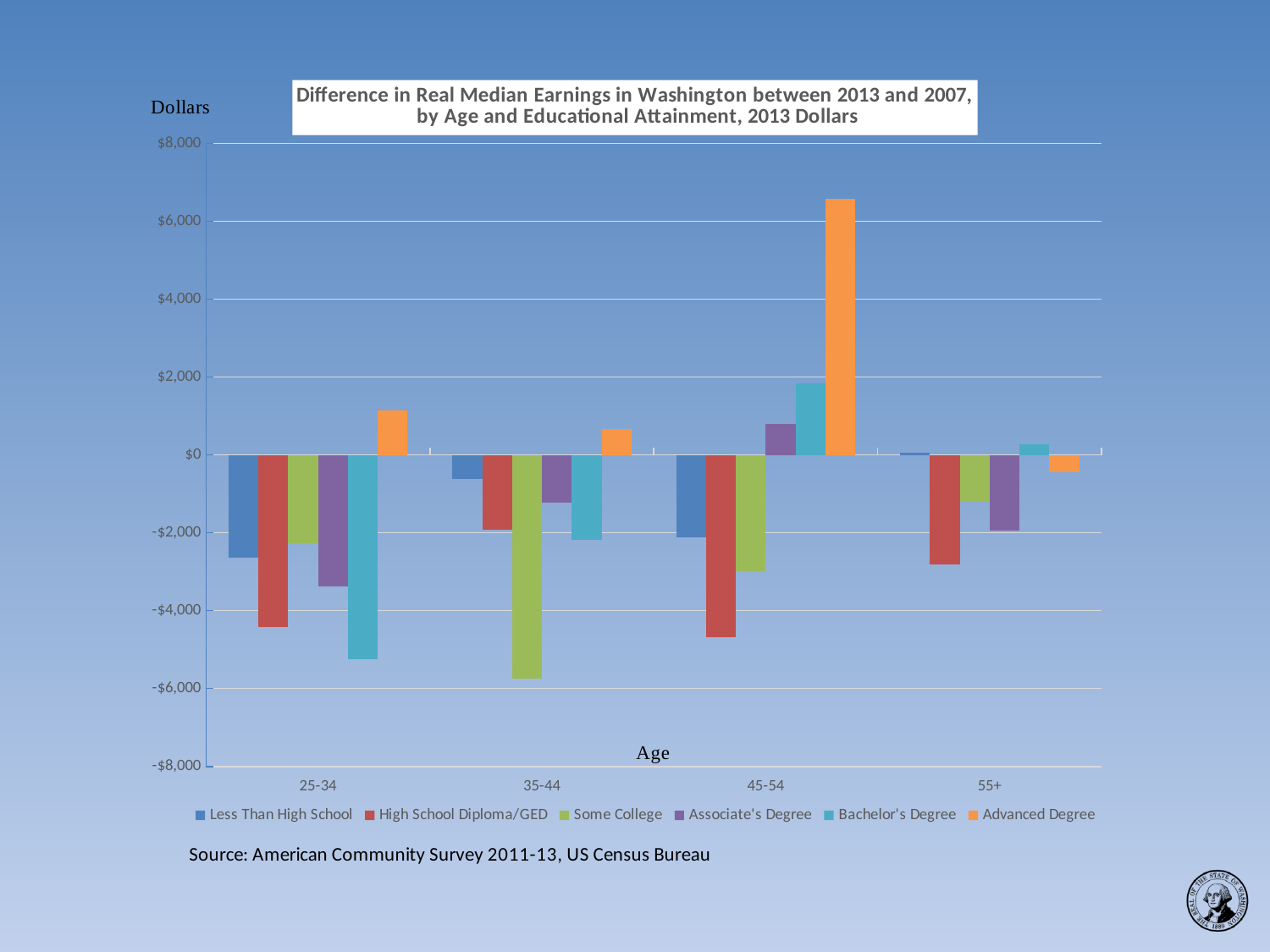
In the 25-34 age group, which is lower: High School Diploma/GED or Some College? High School Diploma/GED Is the value for Advanced Degree in the 45-54 age group greater or less than $6,000? greater What is the title of the chart? Difference in Real Median Earnings in Washington between 2013 and 2007, by Age and Educational Attainment, 2013 Dollars How many series does the legend list? 6 In the 45-54 age group, which is larger: Associate's Degree or Bachelor's Degree? Bachelor's Degree What is the label of the x axis? Age What kind of chart is shown on the slide? Bar chart How many age groups are shown on the x axis? 4 Is the value for Bachelor's Degree in the 25-34 age group greater or less than -$4,000? less Which age group has the highest value for Advanced Degree? 45-54 In the 35-44 age group, which educational attainment level has the lowest value? Some College Is the value for Some College in the 35-44 age group greater or less than -$4,000? less